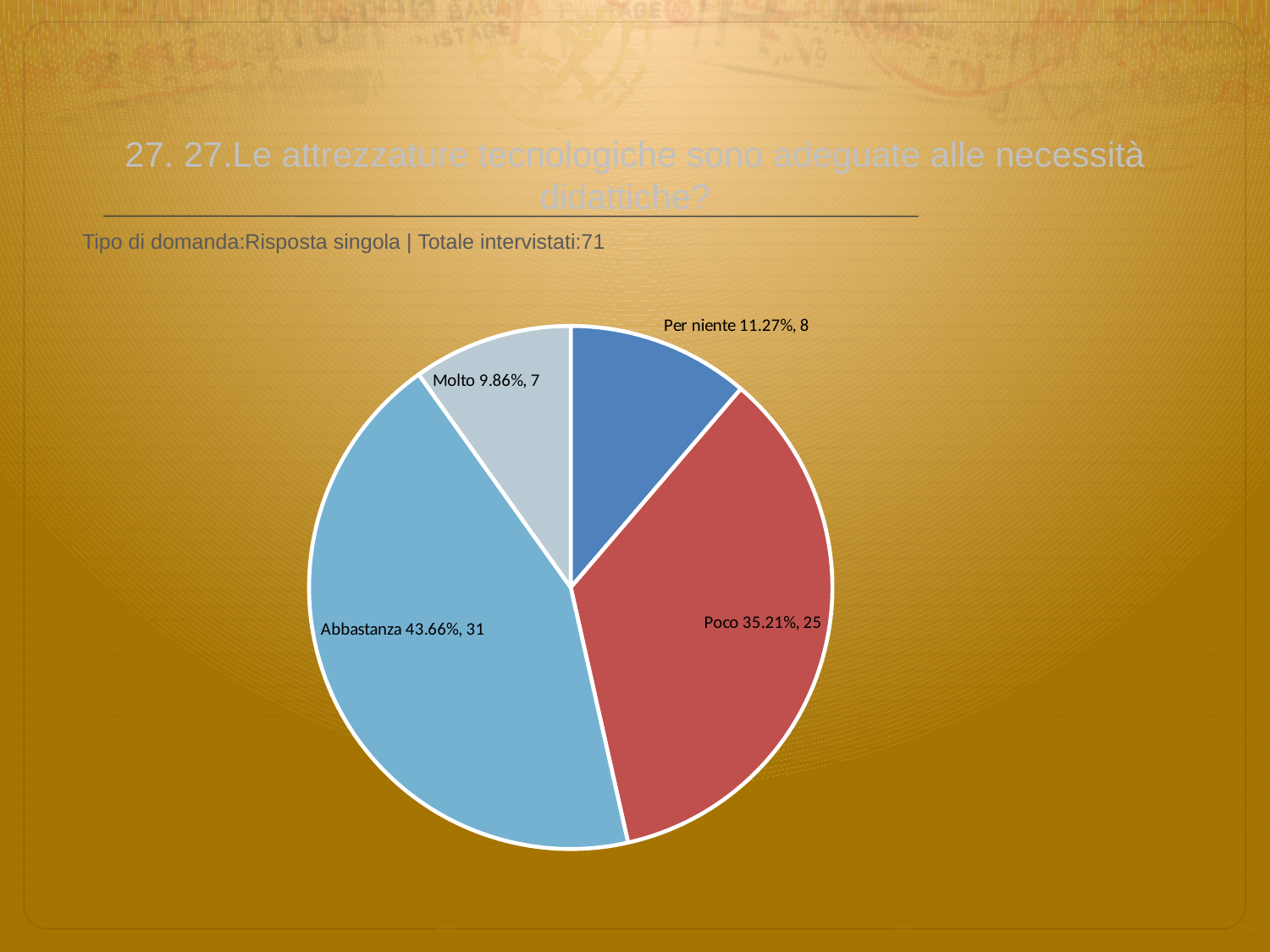
Which has more respondents, 'Per niente' or 'Molto'? Per niente What percentage share does the 'Molto' slice have? 9.86% How many respondents answered 'Per niente'? 8 What is the total number of respondents across all slices? 71 What is the difference in respondent count between 'Abbastanza' and 'Poco'? 6 What percentage share does the 'Abbastanza' slice have? 43.66% How many respondents answered 'Poco'? 25 How many slices does the pie chart have? 4 What colour is the 'Poco' slice? red What kind of chart is shown on the slide? pie chart Which response category has the smallest slice? Molto Which response category has the largest slice? Abbastanza